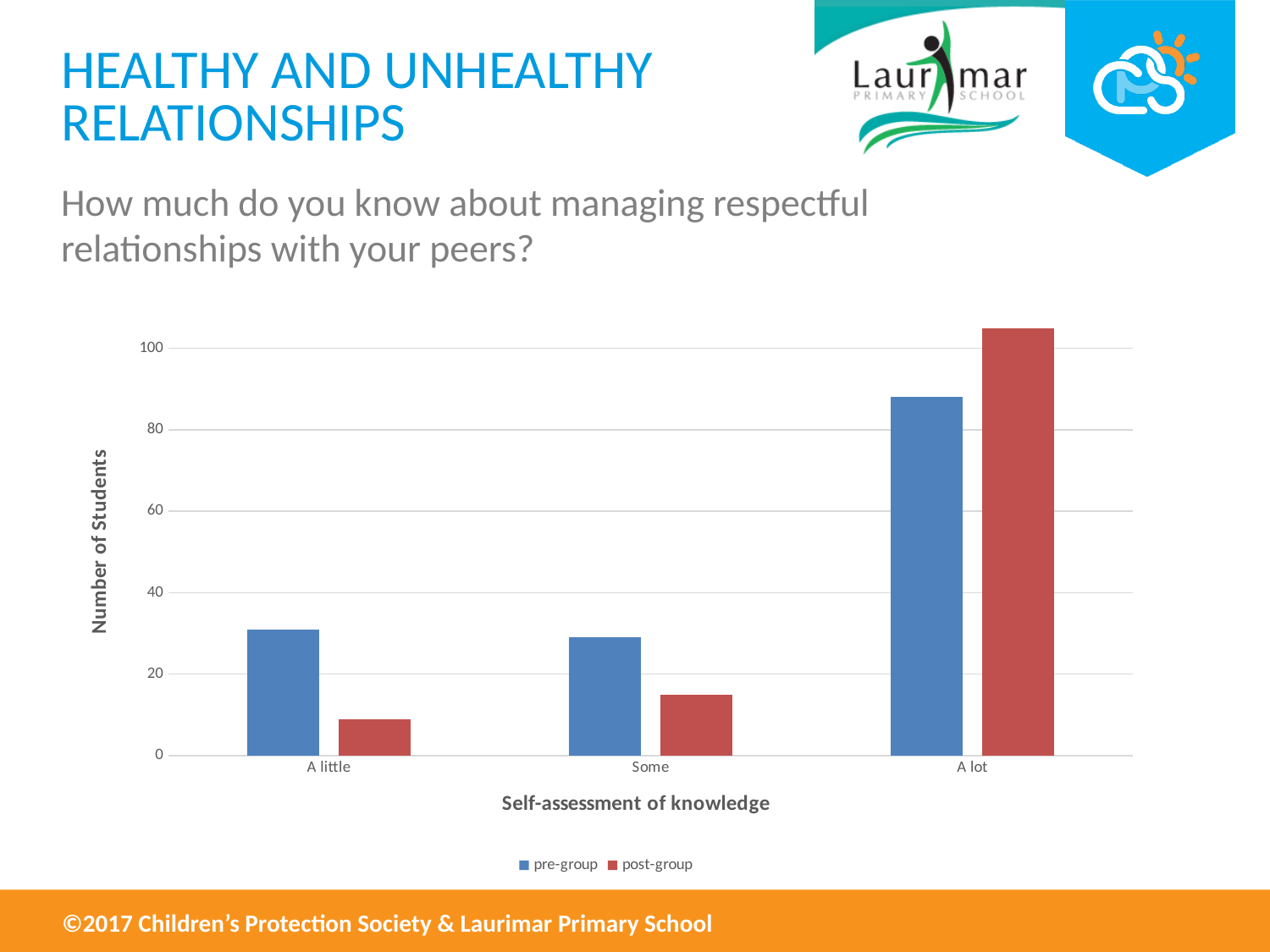
How many series does the legend list? 2 Which category has the highest pre-group value? A lot Which category has the highest post-group value? A lot What kind of chart is shown on the slide? bar chart For the category "A little", which is larger: the pre-group value or the post-group value? pre-group How many categories are shown on the x axis? 3 Is the post-group value for "A lot" greater or less than 100? greater Is the post-group value for "A little" greater or less than 20? less Is the pre-group value for "Some" greater or less than 20? greater Which category has the lowest post-group value? A little For the category "A lot", which is larger: the pre-group value or the post-group value? post-group What is the title of the vertical axis? Number of Students